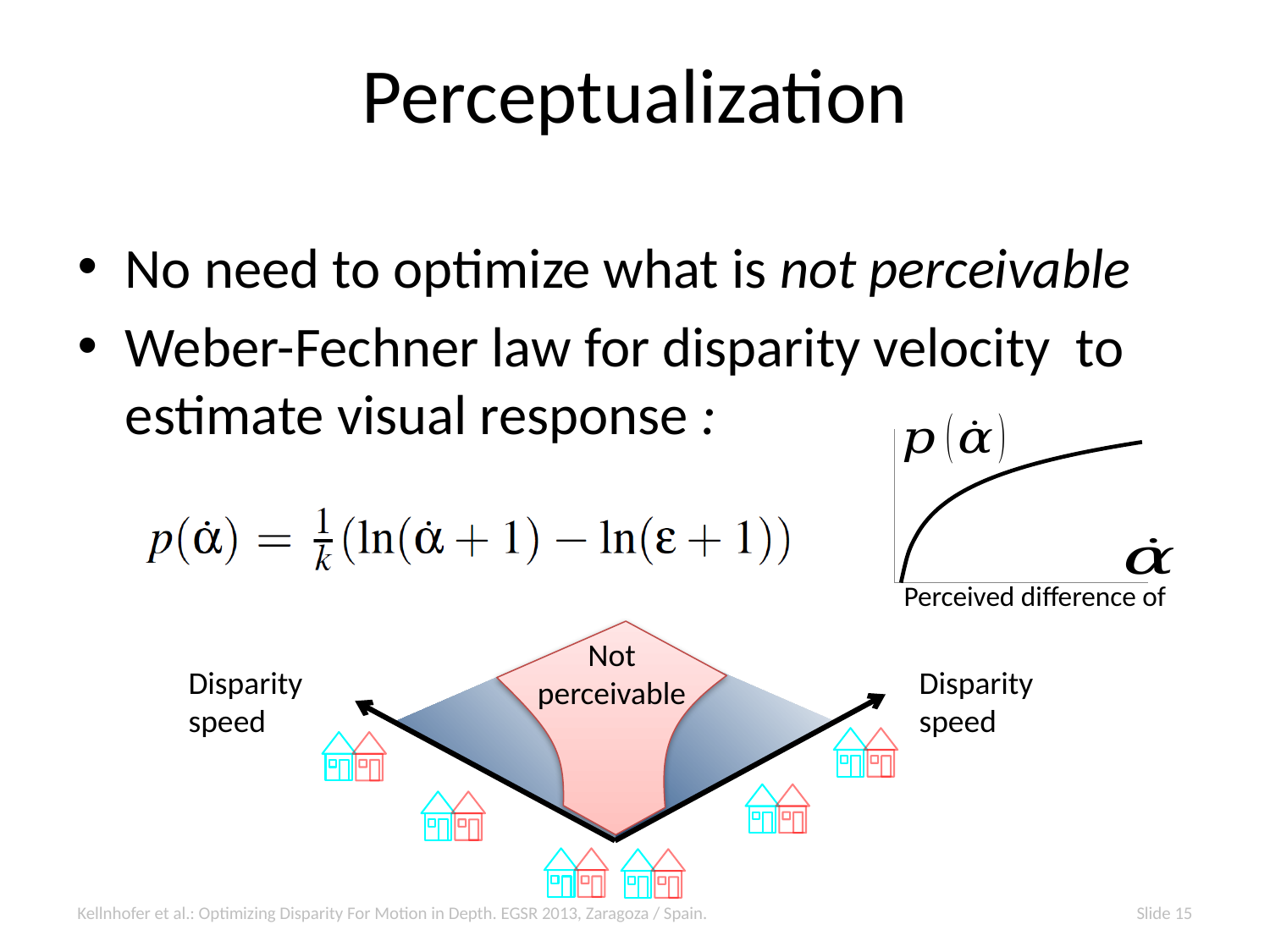
In the small chart in the upper right, does the curve rise or fall as the x axis value increases? rises What is the label on the horizontal axis of the small chart in the upper right? α̇ What kind of chart is the small chart in the upper right of the slide? line chart How many curves are plotted in the small chart in the upper right? 1 What is the label on the vertical axis of the small chart in the upper right? p(α̇)